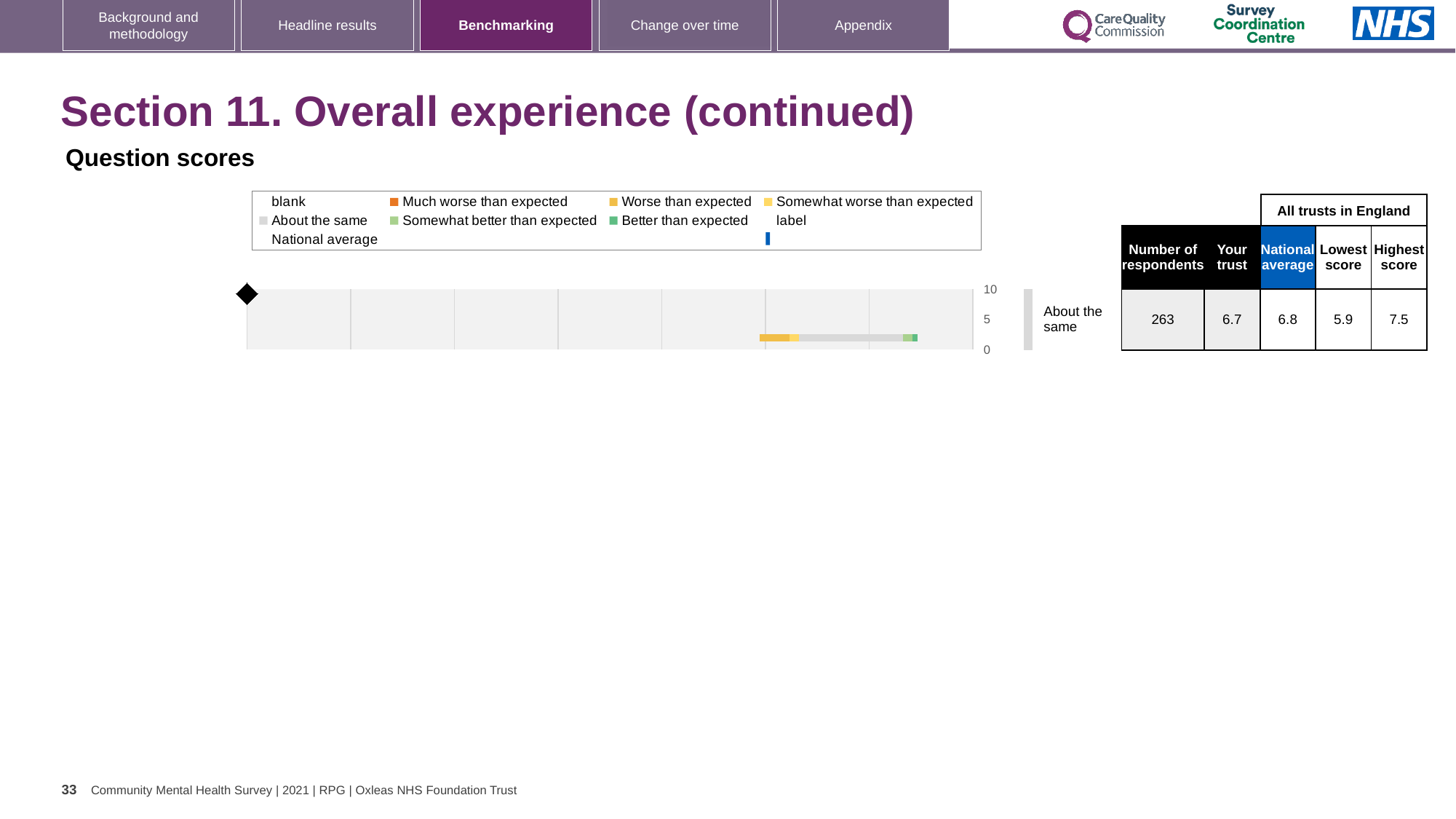
Is the 'Your trust' score for this question greater or less than 5? greater By how much does the national average exceed the 'Your trust' score? 0.1 How many respondents are recorded for this question? 263 What is the highest score among all trusts in England for this question? 7.5 What is the national average score shown for the question? 6.8 What kind of chart is shown on the slide? bar chart What is the 'Your trust' score for the question rated 'About the same'? 6.7 What is the lowest score among all trusts in England for this question? 5.9 Which is larger for this question: the 'Your trust' score or the national average? National average What is the difference between the highest score and the lowest score for this question? 1.6 What is the maximum value shown on the chart's score axis? 10 How many question rows are plotted in the chart? 1